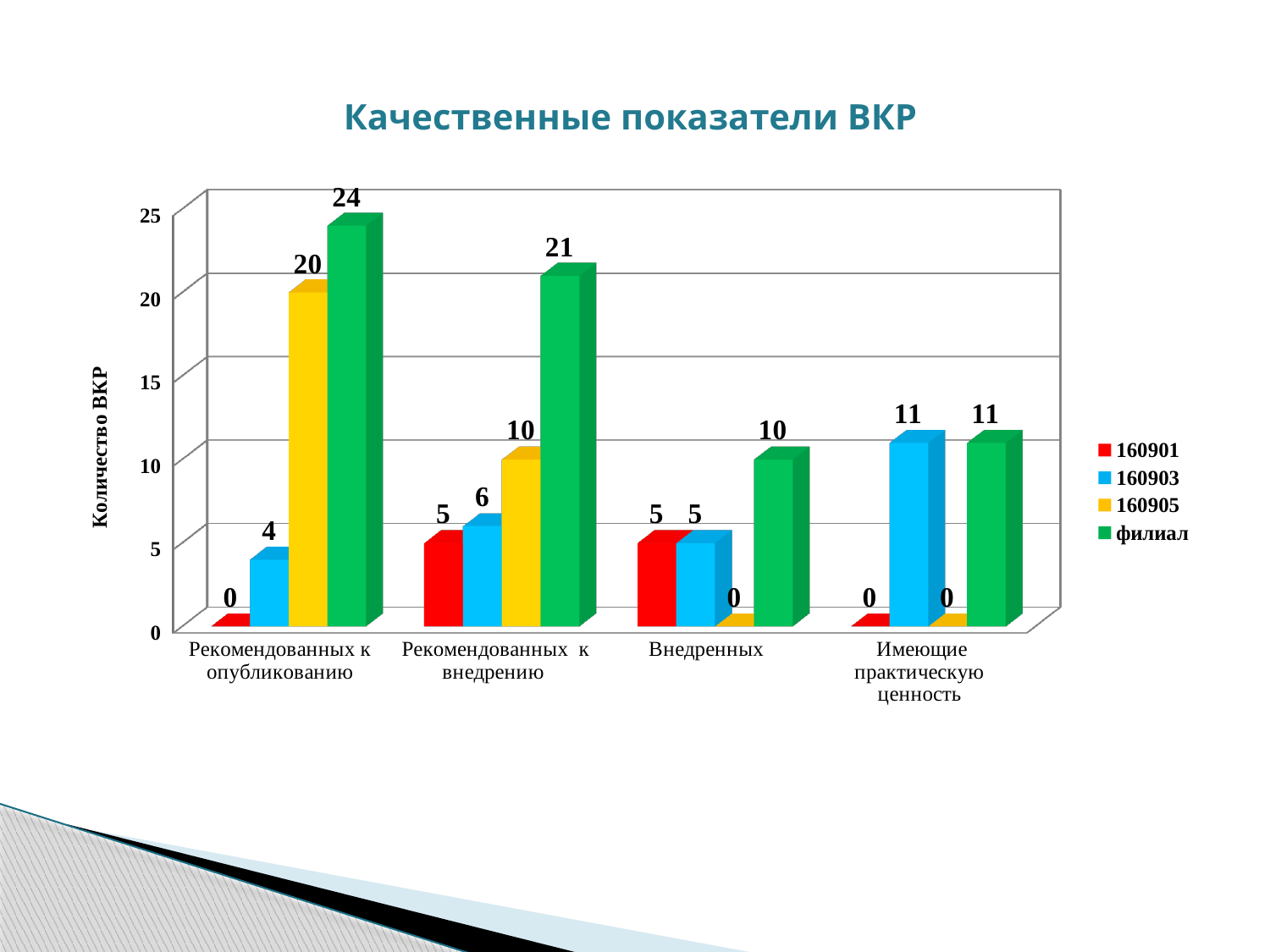
How many series does the legend list? 4 In the category Внедренных, which is larger: the value for филиал or the value for 160901? филиал Which category has the highest value for the series филиал? Рекомендованных к опубликованию What is the value for филиал in the category Рекомендованных к опубликованию? 24 What is the value for 160903 in the category Имеющие практическую ценность? 11 What type of chart is shown on the slide? Bar chart Which series has the lowest value in the category Рекомендованных к внедрению? 160901 What is the title of the chart? Качественные показатели ВКР What is the value for 160905 in the category Рекомендованных к внедрению? 10 What is the difference between the филиал value and the 160905 value in the category Рекомендованных к опубликованию? 4 What is the label of the vertical axis? Количество ВКР How many categories are shown on the x axis? 4